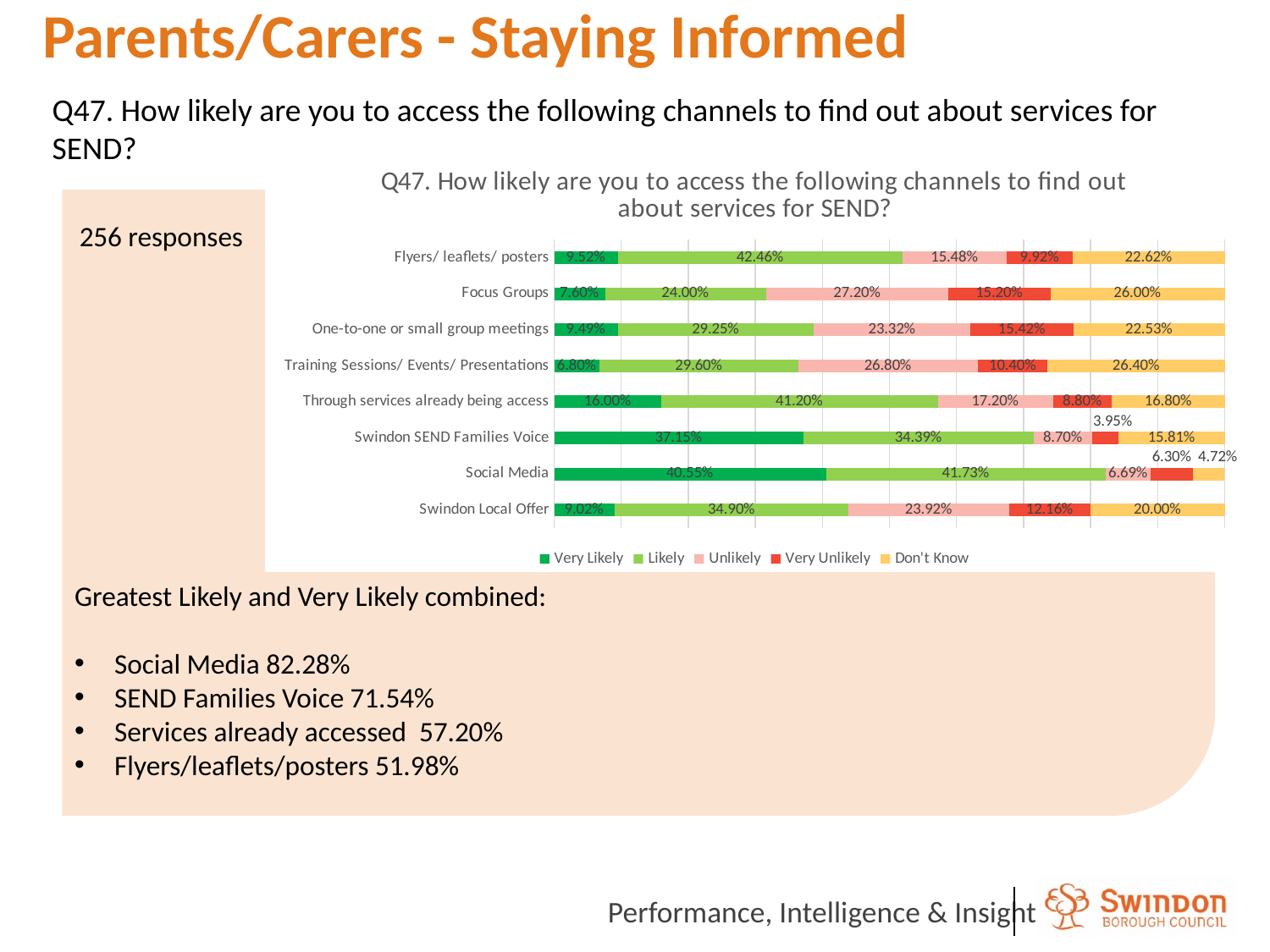
What is the 'Unlikely' value for Swindon Local Offer? 23.92% What is the 'Don't Know' value for Focus Groups? 26.00% What is the 'Very Unlikely' value for Swindon SEND Families Voice? 3.95% What percentage of respondents said they are 'Very Likely' to access Social Media to find out about SEND services? 40.55% For Social Media, what is the difference between the 'Likely' and 'Very Likely' percentages? 1.18% How many series does the chart legend list? 5 How many channels (categories) are shown in the chart? 8 Which channel has the highest 'Very Likely' percentage? Social Media Which channel has the lowest 'Very Likely' percentage? Training Sessions/ Events/ Presentations Which has a larger 'Likely' percentage: Flyers/ leaflets/ posters or Focus Groups? Flyers/ leaflets/ posters What is the combined 'Very Likely' and 'Likely' percentage for Social Media? 82.28% What type of chart is used on this slide? Stacked bar chart